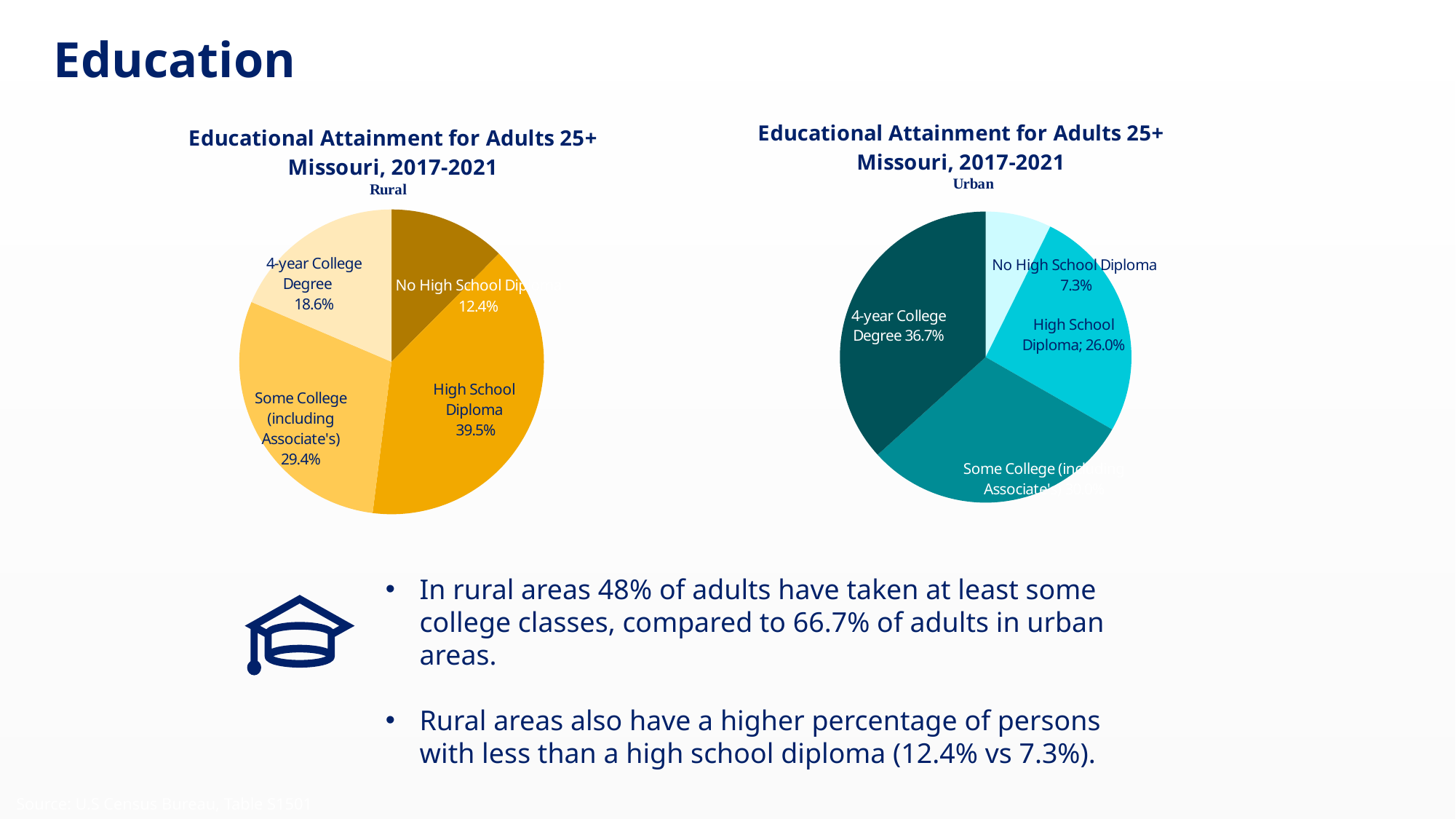
What type of chart is used for the Rural educational attainment data? pie chart How many categories does the Rural pie chart show? 4 In the Rural pie chart, what percentage of adults have Some College (including Associate's)? 29.4% What is the difference between the Rural and Urban percentages of adults with No High School Diploma? 5.1% In the Rural pie chart, what percentage of adults have a 4-year College Degree? 18.6% In the Urban pie chart, which category has the smallest share? No High School Diploma In the Rural pie chart, which category has the largest share? High School Diploma In the Urban pie chart, what percentage of adults have a High School Diploma? 26.0% In the Urban pie chart, what percentage of adults have No High School Diploma? 7.3% Which is larger: the share of adults with a 4-year College Degree in the Rural chart or in the Urban chart? Urban In the Urban pie chart, what percentage of adults have a 4-year College Degree? 36.7% In the Rural pie chart, what percentage of adults have a High School Diploma? 39.5%